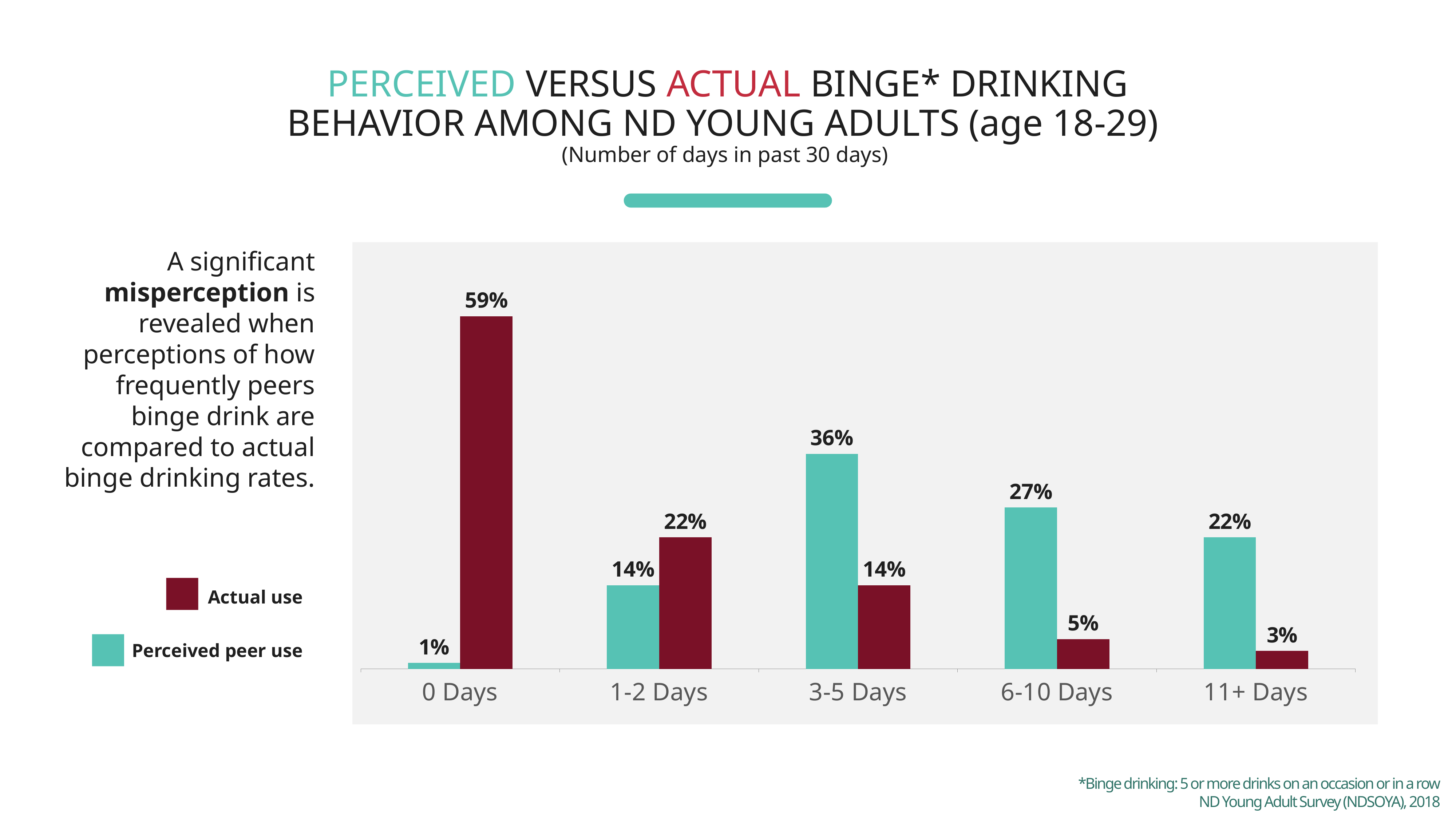
What is the Perceived peer use value for 6-10 Days? 27% Which category has the highest Perceived peer use value? 3-5 Days Which category has the lowest Actual use value? 11+ Days What kind of chart is shown on the slide? Bar chart Which colour represents Actual use in the legend? Dark red What is the Actual use value for 0 Days? 59% What is the Perceived peer use value for 3-5 Days? 36% Which is larger for 1-2 Days, Actual use or Perceived peer use? Actual use How many day categories are shown on the x axis? 5 What is the Actual use value for 11+ Days? 3% How many series does the legend list? 2 What is the difference between Actual use and Perceived peer use for 0 Days? 58%